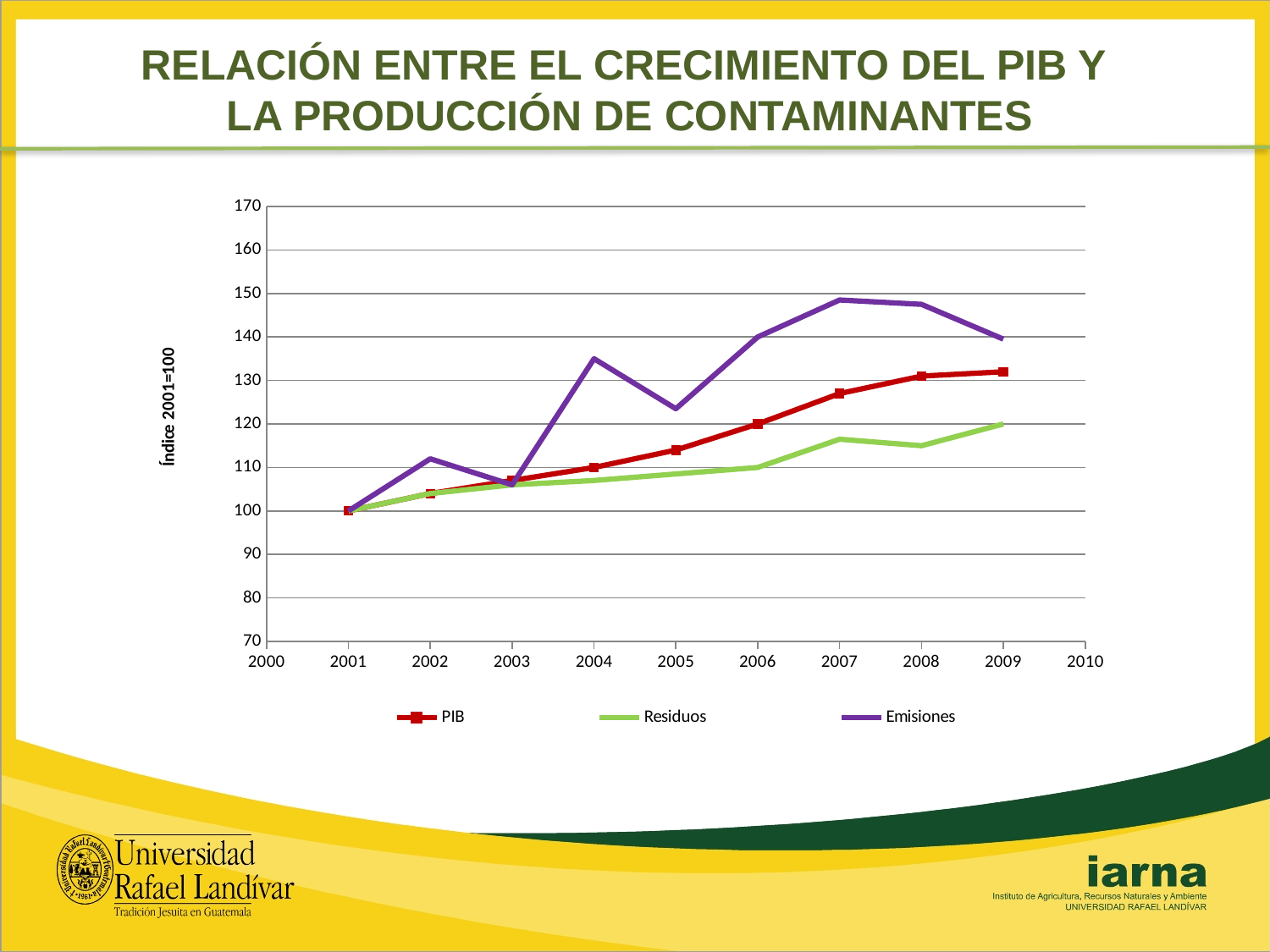
In 2009, which series has the higher value, PIB or Emisiones? Emisiones Is the value for Emisiones in 2005 greater or less than 130? less How many years have data points plotted for the PIB series? 9 What is the value of the PIB series in 2001? 100 Does the PIB series rise or fall from 2001 to 2009? Rises Is the value for Residuos in 2008 greater or less than 120? less How many series does the legend list? 3 Which series has the lowest value in 2009? Residuos What is the label on the vertical axis? Índice 2001=100 Which series are listed in the legend? PIB, Residuos, Emisiones What kind of chart is shown on the slide? Line chart Is the value for Emisiones in 2007 greater or less than 140? greater